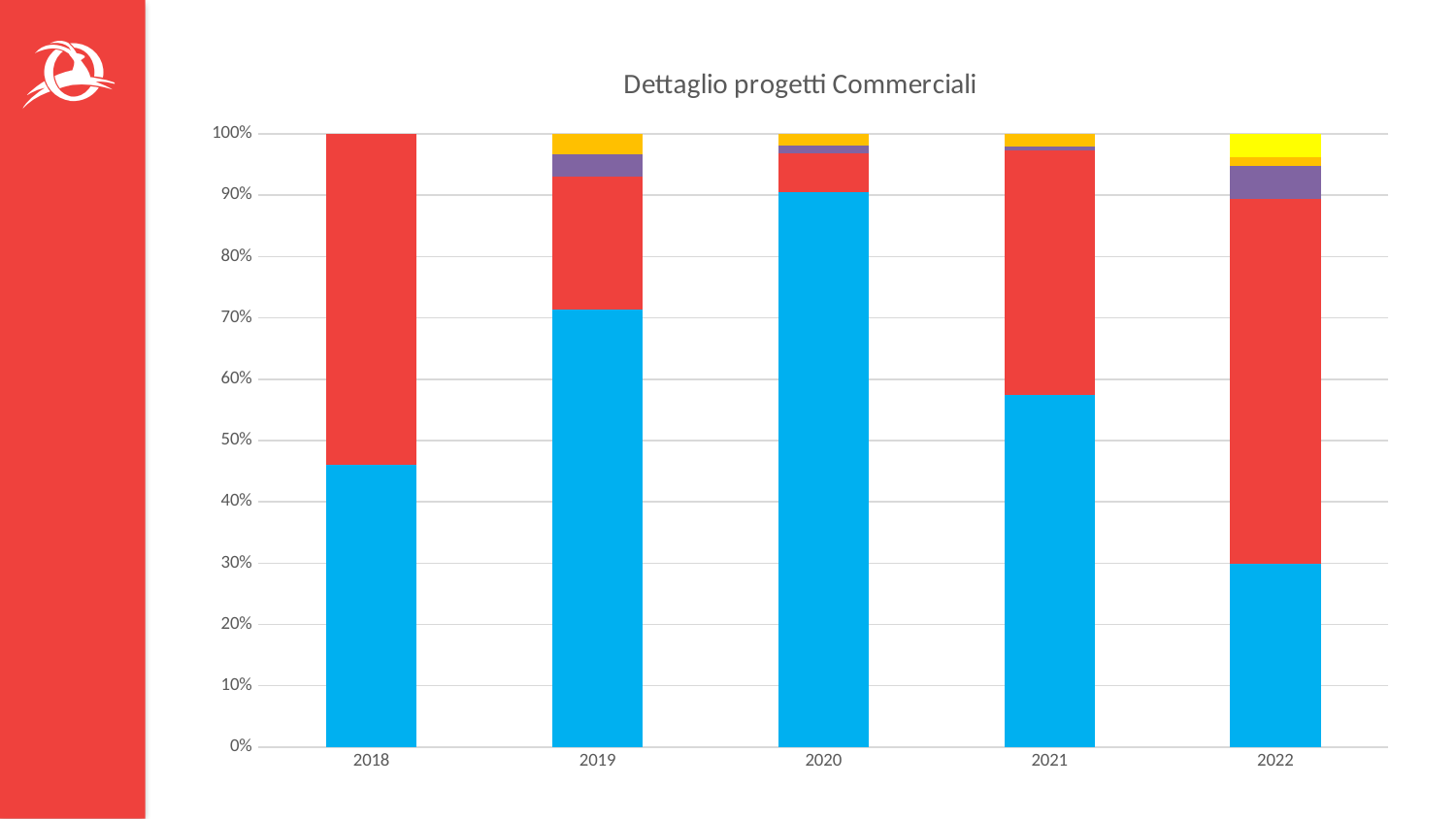
Is the blue segment for 2018 greater or less than 50%? less What is the title of the chart? Dettaglio progetti Commerciali Is the blue segment for 2020 greater or less than 80%? greater Is the blue segment for 2021 greater or less than 60%? less What is the total height of the 2018 bar? 100% What kind of chart is shown on the slide? stacked bar chart Is the blue segment larger in 2019 or in 2021? 2019 Does the blue segment rise or fall from 2020 to 2022? fall In which year is the blue segment the largest? 2020 In which year is the blue segment the smallest? 2022 How many years are shown on the x axis of the chart? 5